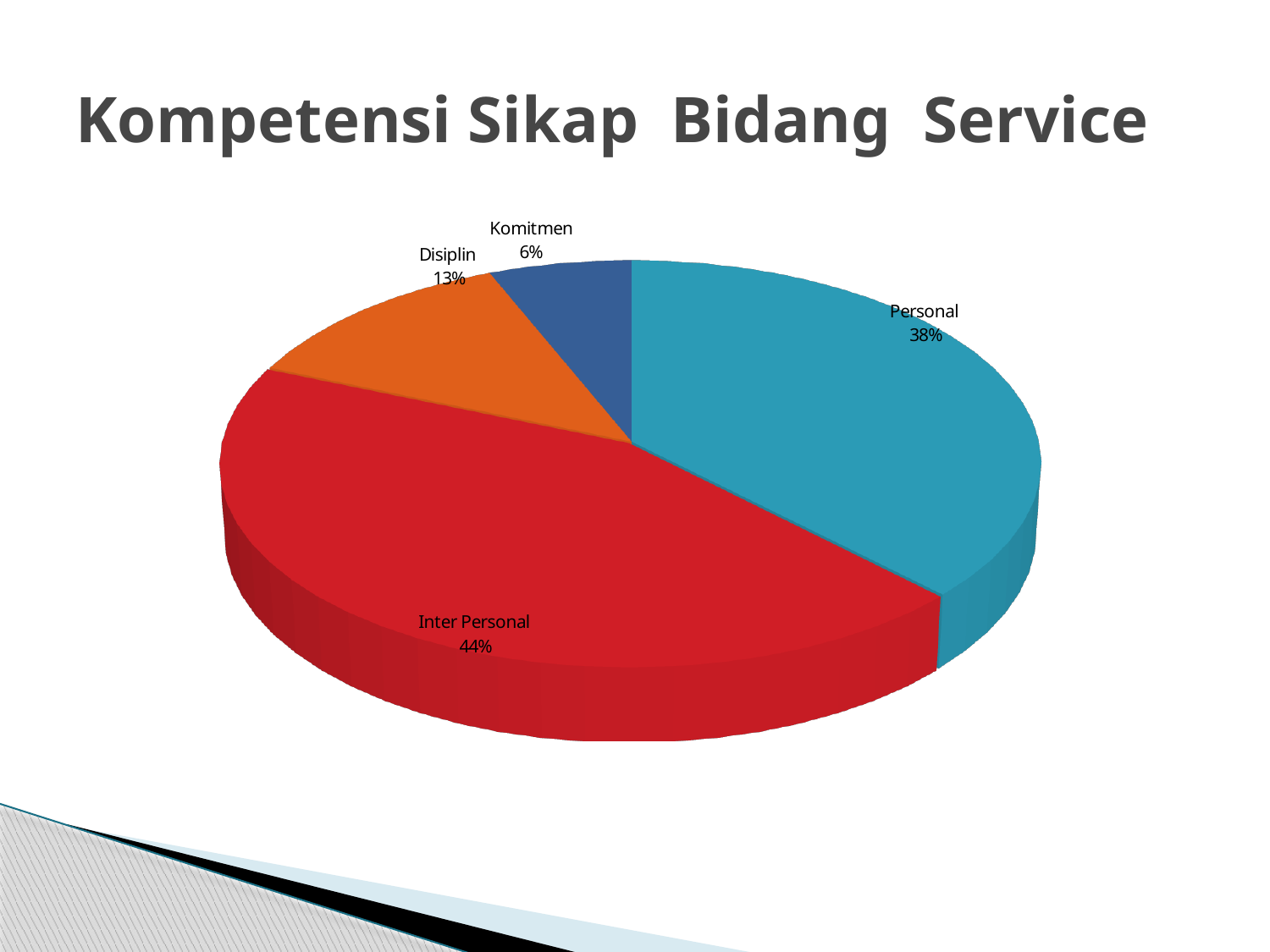
How many categories are shown in the pie chart? 4 What kind of chart is shown on the slide? Pie chart Which category has the largest slice? Inter Personal Which category has the smallest slice? Komitmen Which is larger, Disiplin or Komitmen? Disiplin What is the value shown for Personal? 38% What is the difference between the Inter Personal and Personal shares? 6% What is the difference between the Disiplin and Komitmen shares? 7% What is the value shown for Disiplin? 13% What is the value shown for Komitmen? 6% What is the title of the slide? Kompetensi Sikap Bidang Service What share of the pie does Inter Personal have? 44%